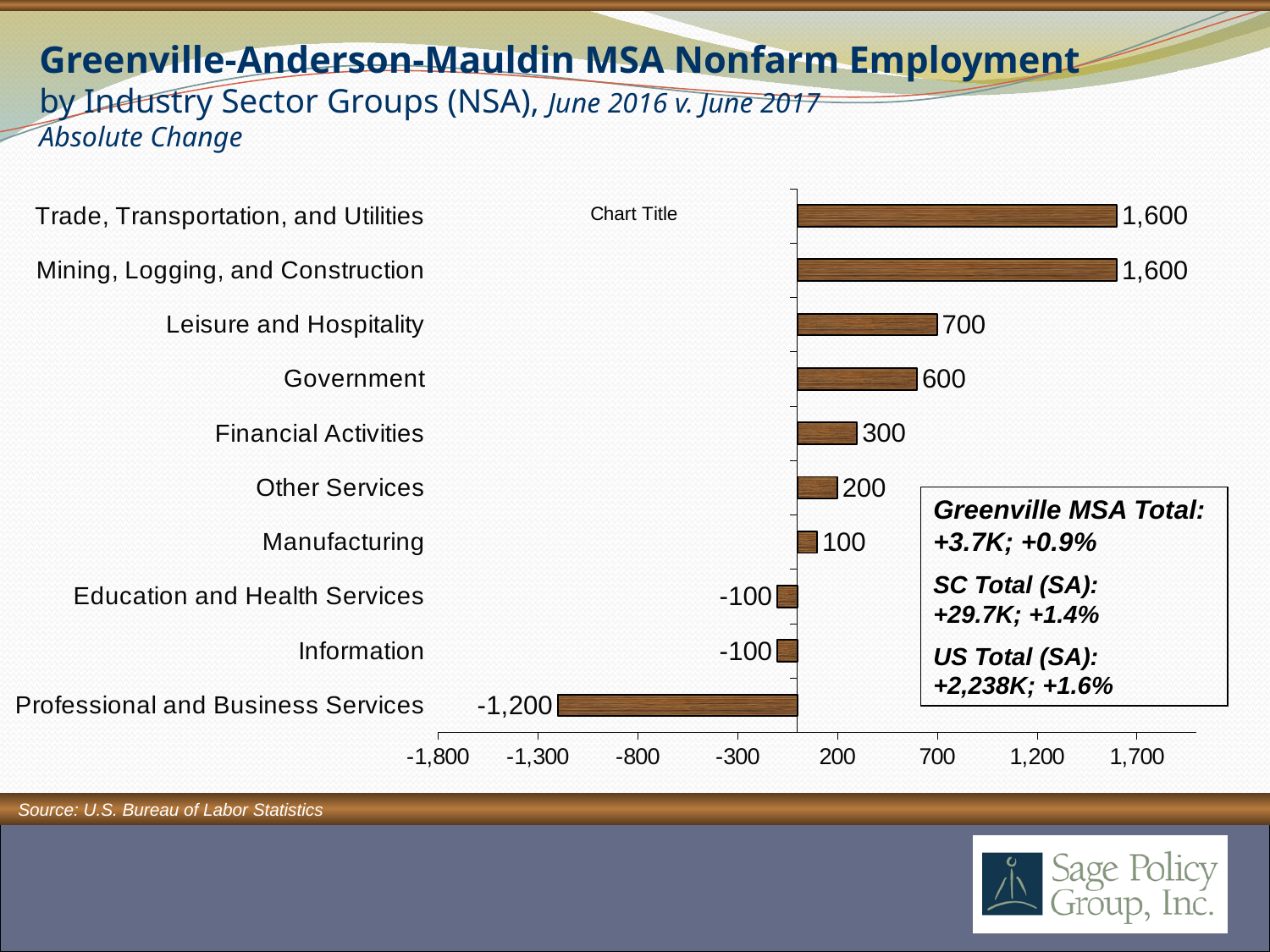
What is the value shown for Mining, Logging, and Construction? 1,600 What kind of chart is shown on the slide? Bar chart According to the slide, what is the source of the data? U.S. Bureau of Labor Statistics What is the difference between the values for Leisure and Hospitality and Government? 100 What is the value shown for Government? 600 What is the value shown for Professional and Business Services? -1,200 How many industry sector groups are shown on the chart? 10 What is the difference between the values for Trade, Transportation, and Utilities and Financial Activities? 1,300 Which has a larger value, Manufacturing or Other Services? Other Services What is the absolute change in employment for Leisure and Hospitality? 700 Which industry sector group has the lowest value on the chart? Professional and Business Services Which has a larger value, Government or Financial Activities? Government